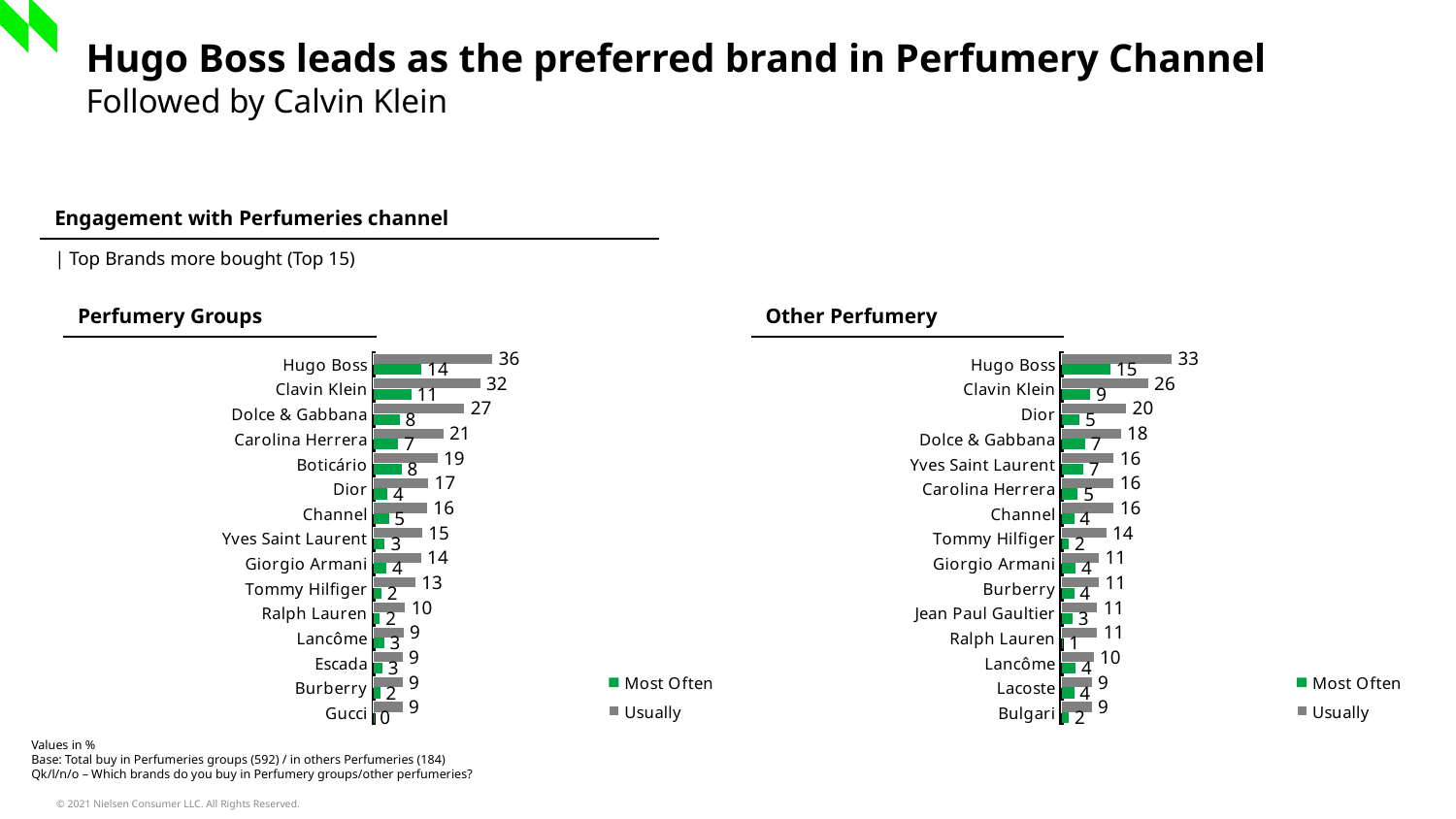
How many series does the legend of the Other Perfumery chart list? 2 In the Other Perfumery chart, which colour represents the Most Often series? Green What type of chart is the Perfumery Groups chart? Bar chart In the Perfumery Groups chart, what is the Usually value for Hugo Boss? 36 In the Perfumery Groups chart, what is the Most Often value for Dolce & Gabbana? 8 In the Other Perfumery chart, which brand has the highest Usually value? Hugo Boss In the Perfumery Groups chart, what is the difference between the Usually values for Hugo Boss and Clavin Klein? 4 In the Other Perfumery chart, which is larger: the Usually value for Clavin Klein or the Usually value for Dior? Clavin Klein In the Other Perfumery chart, what is the Usually value for Dior? 20 In the Other Perfumery chart, what is the Most Often value for Hugo Boss? 15 In the Perfumery Groups chart, which brand has the lowest Most Often value? Gucci How many brands are shown in the Perfumery Groups chart? 15